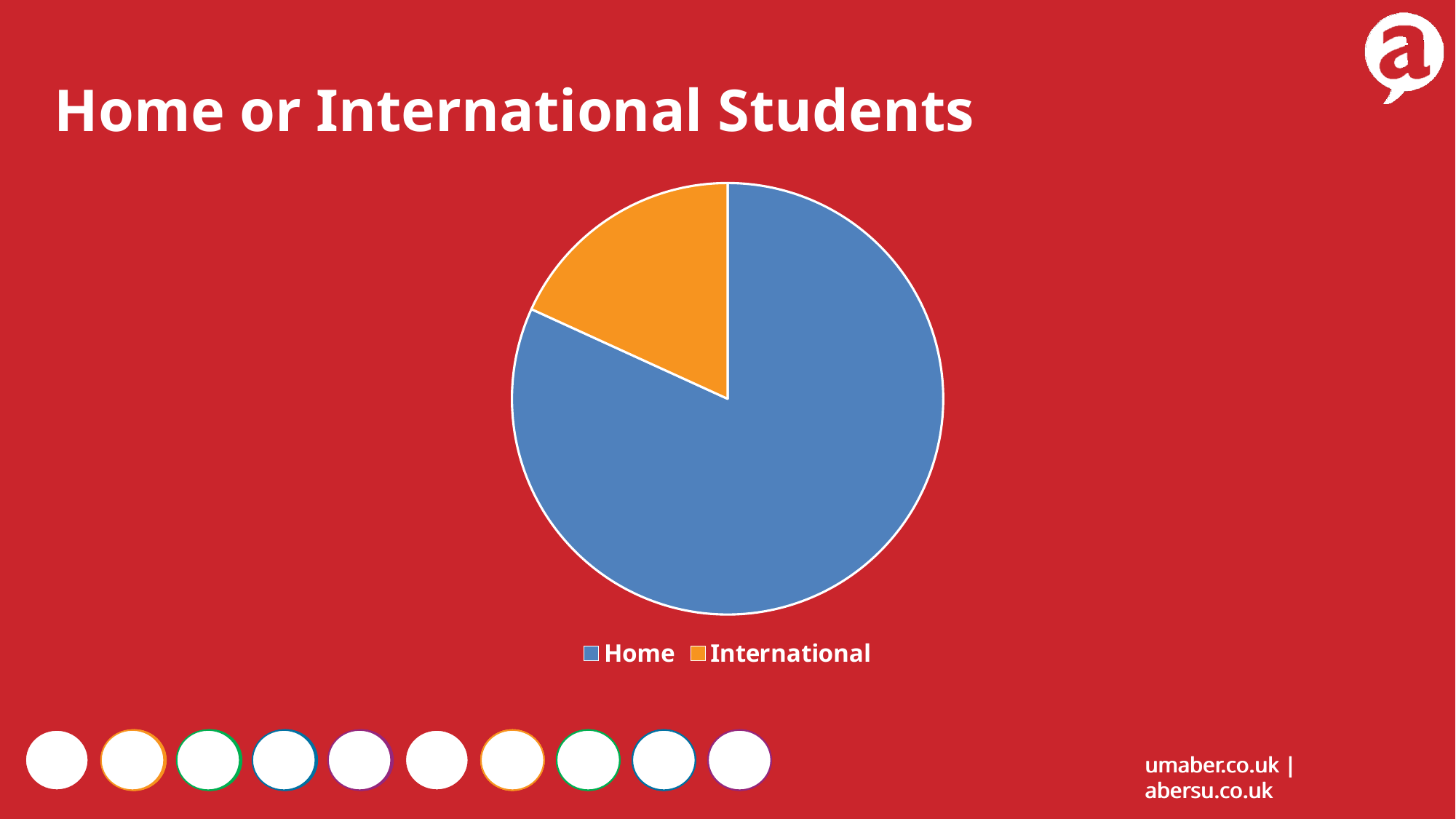
How many entries does the legend list? 2 What is the title of the slide containing the pie chart? Home or International Students Which slice is larger, Home or International? Home What kind of chart is shown on the slide? pie chart How many slices does the pie chart have? 2 Which category has the smallest slice of the pie? International What colour is the Home slice of the pie chart? blue Which category has the largest slice of the pie? Home Which category is shown in orange in the pie chart? International